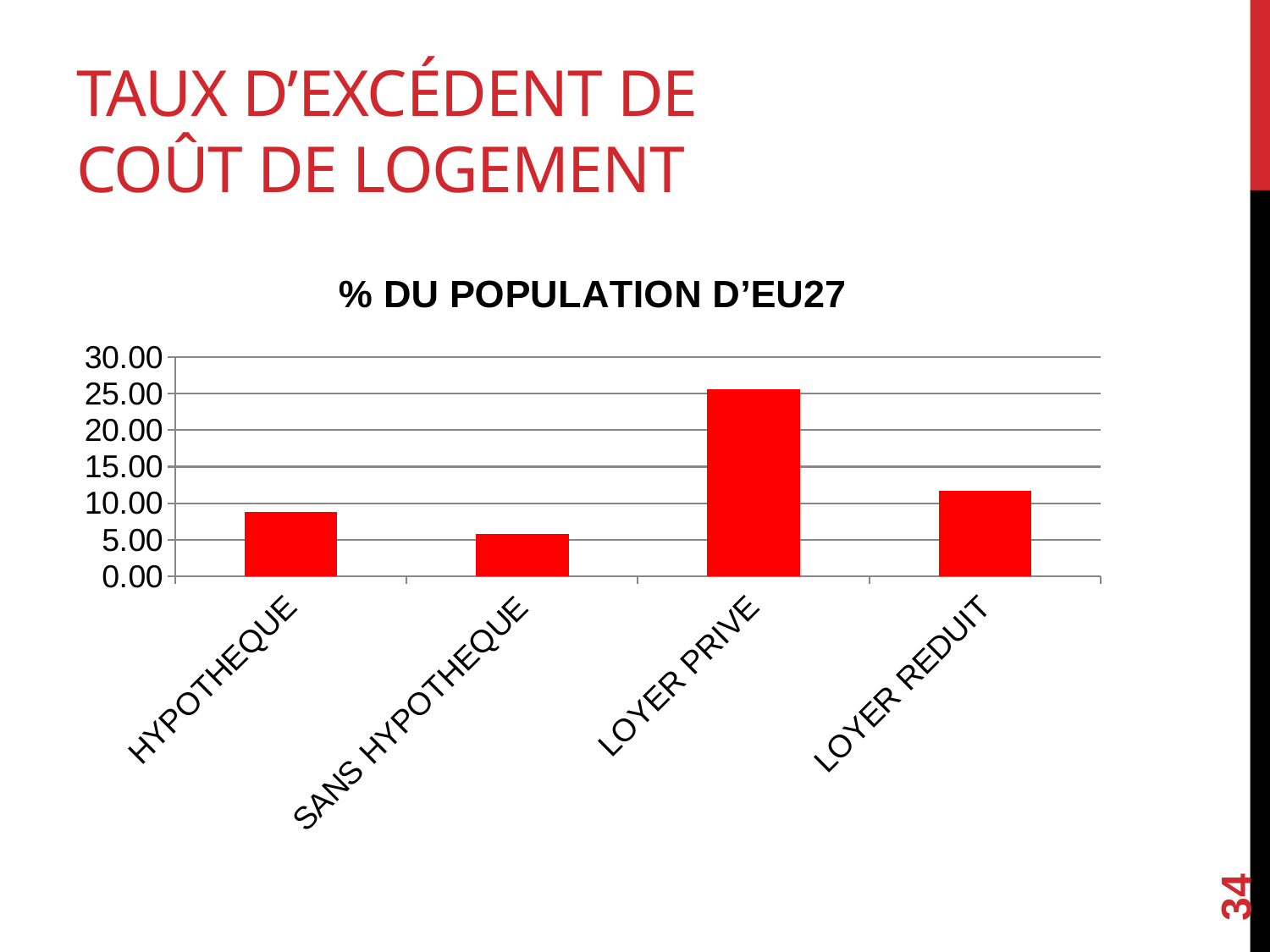
Which is larger, the value for LOYER REDUIT or the value for HYPOTHEQUE? LOYER REDUIT What is the title of the chart? % DU POPULATION D'EU27 Is the value for LOYER REDUIT greater or less than 10.00? greater Which category has the lowest value? SANS HYPOTHEQUE How many categories are shown on the x axis of the chart? 4 Which category has the highest value? LOYER PRIVE Is the value for SANS HYPOTHEQUE greater or less than 10.00? less What colour are the bars in the chart? red Is the value for LOYER PRIVE greater or less than 20.00? greater What kind of chart is shown on the slide? bar chart Which is larger, the value for HYPOTHEQUE or the value for SANS HYPOTHEQUE? HYPOTHEQUE